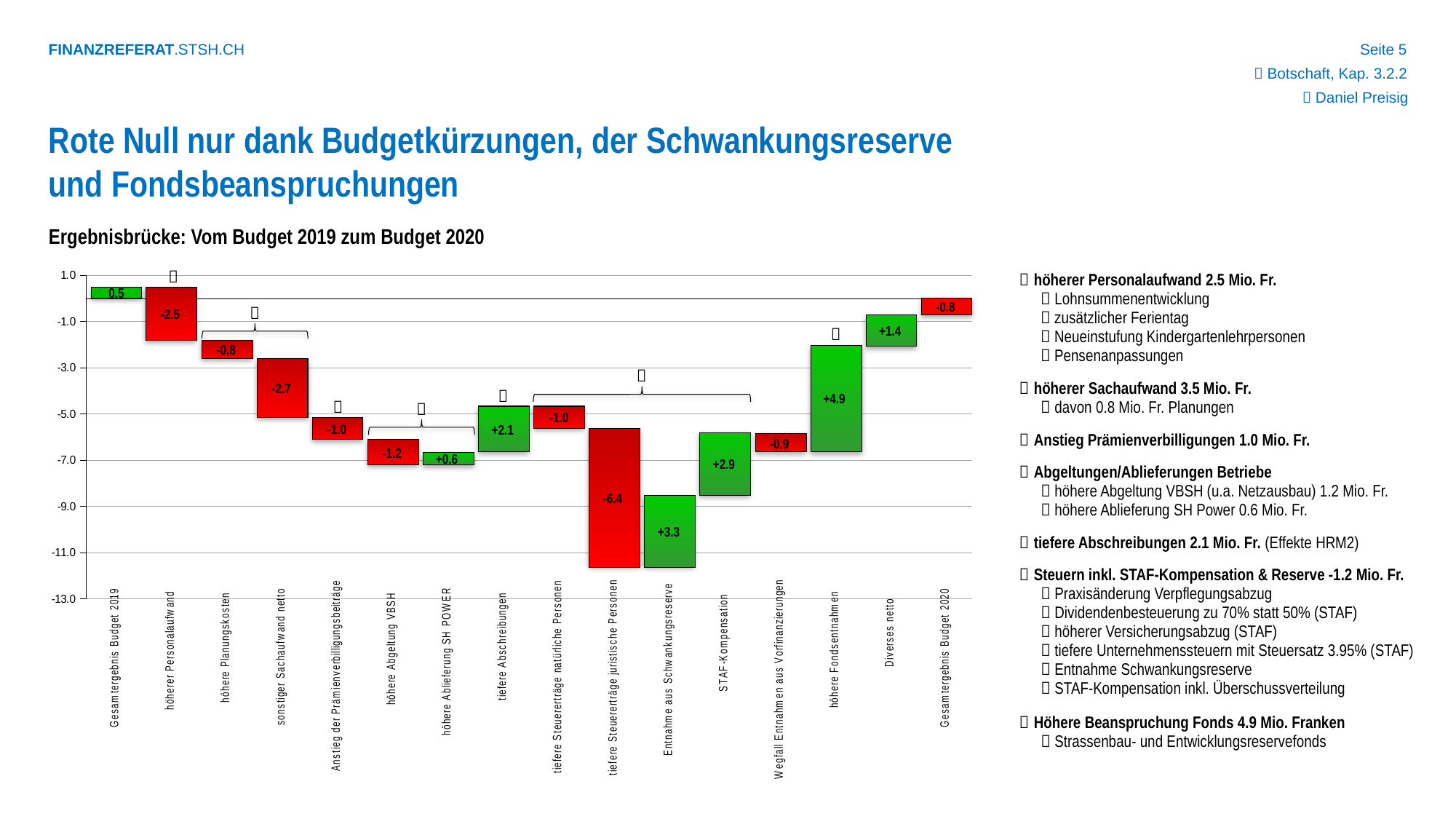
What is the value shown for 'Entnahme aus Schwankungsreserve'? +3.3 What is the difference between the values for 'STAF-Kompensation' and 'tiefere Abschreibungen'? 0.8 What kind of chart is shown on the slide? Waterfall bar chart What is the value shown for 'höherer Personalaufwand'? -2.5 Which category has the largest negative value? tiefere Steuererträge juristische Personen Which category has the largest positive value? höhere Fondsentnahmen How many categories are shown on the x axis of the chart? 16 What is the value shown for 'Gesamtergebnis Budget 2020'? -0.8 What colour are the bars with negative values? Red What is the value shown for 'höhere Fondsentnahmen'? +4.9 What is the title of the chart? Ergebnisbrücke: Vom Budget 2019 zum Budget 2020 Which is larger in absolute value: 'sonstiger Sachaufwand netto' or 'höhere Planungskosten'? sonstiger Sachaufwand netto